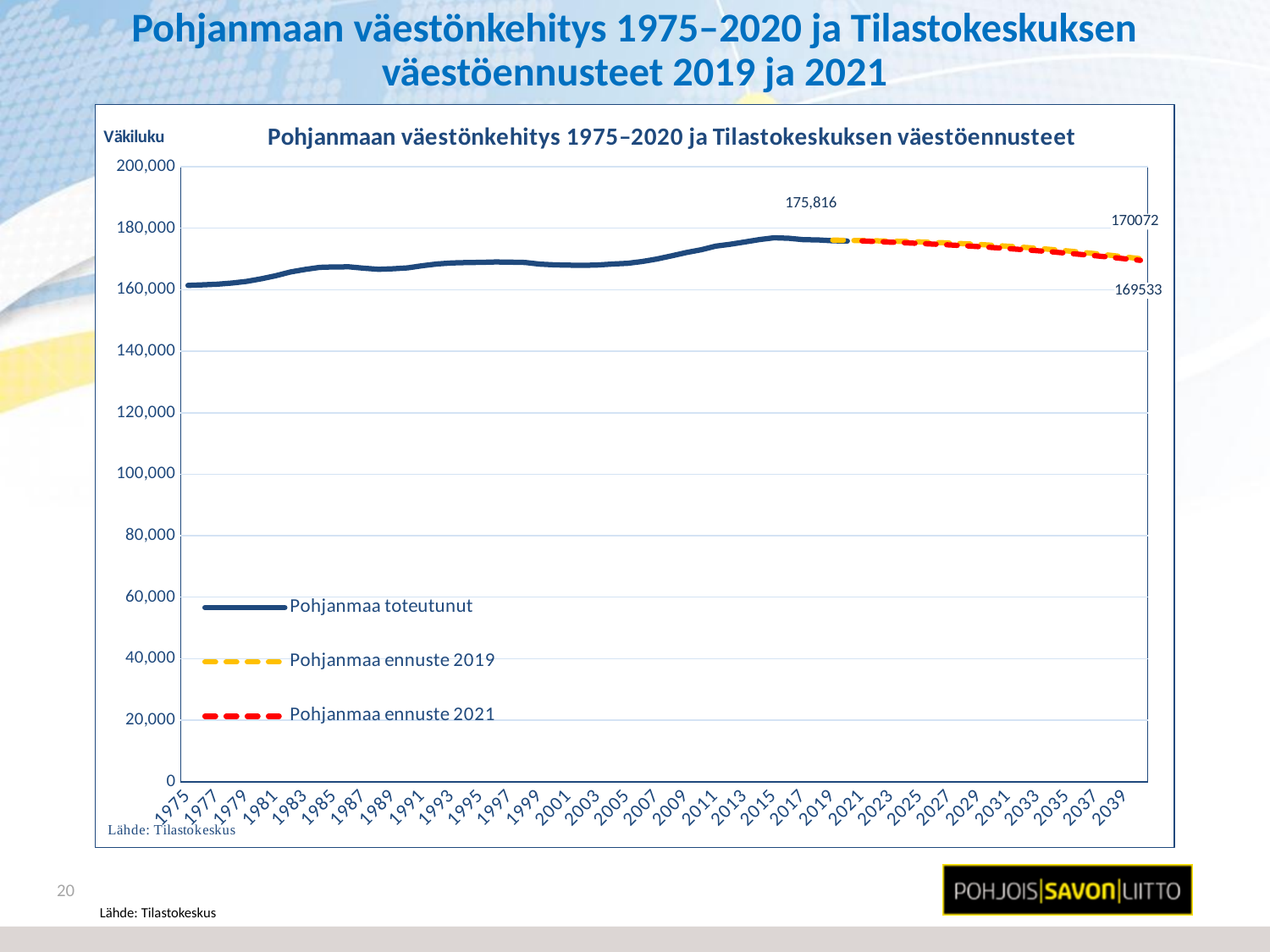
Is the value for Pohjanmaa toteutunut in 1975 greater or less than 180,000? less Do the forecast lines (ennuste 2019 and ennuste 2021) rise or fall from 2020 to 2039? fall Is the value for Pohjanmaa toteutunut in 2015 greater or less than 160,000? greater What is the difference between the end values of Pohjanmaa ennuste 2019 (170072) and Pohjanmaa ennuste 2021 (169533)? 539 Which forecast ends at a higher value, Pohjanmaa ennuste 2019 or Pohjanmaa ennuste 2021? Pohjanmaa ennuste 2019 What is the data label shown at the end of the Pohjanmaa ennuste 2021 line? 169533 How many series does the legend list? 3 What is the highest value shown on the vertical axis? 200,000 What kind of chart is shown on the slide? line chart What is the data label printed on the Pohjanmaa toteutunut line? 175,816 What is the data label shown at the end of the Pohjanmaa ennuste 2019 line? 170072 What is the label of the vertical axis? Väkiluku